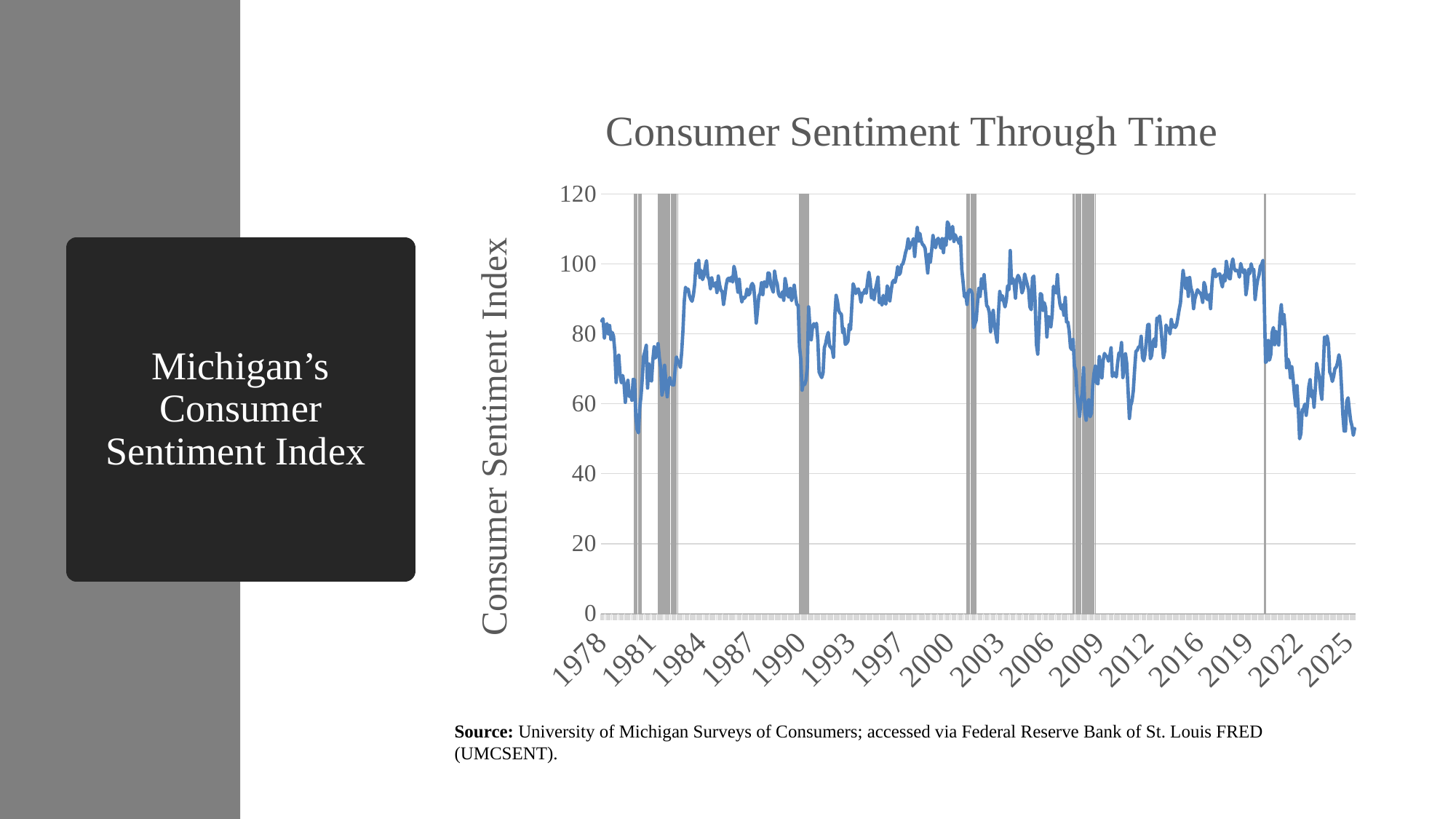
What kind of chart is shown on the slide? line chart What is the title of the chart? Consumer Sentiment Through Time Does the line generally rise or fall between 2009 and 2019? rise Is the lowest value of the line around 2022 greater or less than 60? less Does the line rise or fall between 2019 and 2022? fall How many year labels are shown on the horizontal axis? 16 Which is higher: the peak of the line around 2000 or the peak around 2019? around 2000 Is the lowest value of the line around 1981 greater or less than 60? less Is the lowest value of the line around 2009 greater or less than 80? less What is the label on the vertical axis of the chart? Consumer Sentiment Index